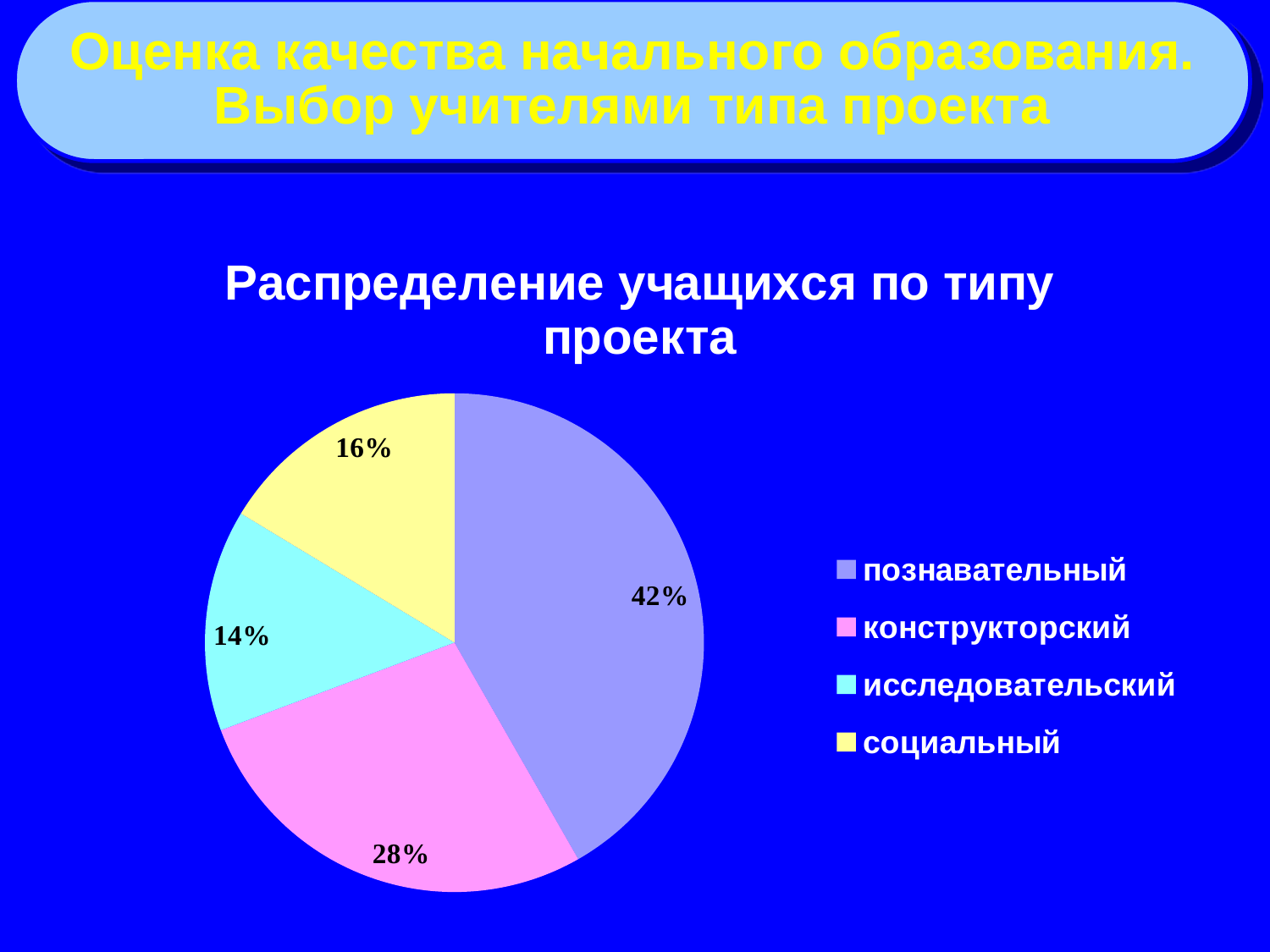
What share of the pie does the познавательный slice represent? 42% What share of the pie does the конструкторский slice represent? 28% What type of chart is shown on the slide? pie chart Which slice is larger: социальный or исследовательский? социальный What is the difference in percentage points between the познавательный and конструкторский slices? 14 Which project type has the smallest share of students? исследовательский What is the title of the chart? Распределение учащихся по типу проекта What share of the pie does the исследовательский slice represent? 14% What colour is the конструкторский slice in the legend? pink Which project type has the largest share of students? познавательный How many slices does the pie chart have? 4